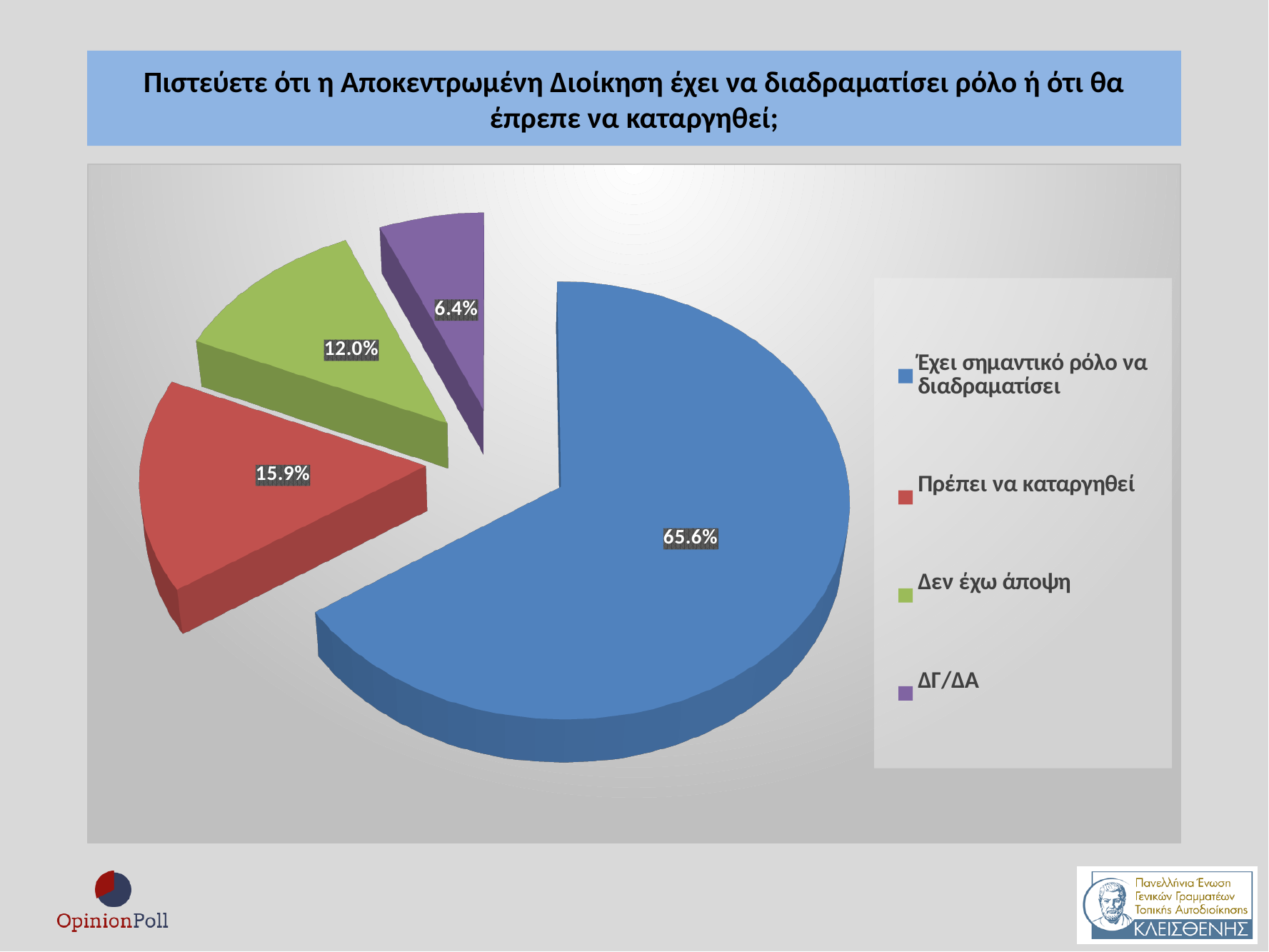
What percentage of respondents answered 'ΔΓ/ΔΑ'? 6.4% What type of chart is shown on the slide? Pie chart Which response has the largest share of the pie? Έχει σημαντικό ρόλο να διαδραματίσει Which is larger: the share for 'Πρέπει να καταργηθεί' or the share for 'Δεν έχω άποψη'? Πρέπει να καταργηθεί What percentage of respondents answered 'Έχει σημαντικό ρόλο να διαδραματίσει'? 65.6% What percentage of respondents answered 'Δεν έχω άποψη'? 12.0% What colour is the slice for 'Δεν έχω άποψη'? Green What is the difference in percentage points between 'Έχει σημαντικό ρόλο να διαδραματίσει' and 'Πρέπει να καταργηθεί'? 49.7 Which response has the smallest share of the pie? ΔΓ/ΔΑ What is the combined share of 'Δεν έχω άποψη' and 'ΔΓ/ΔΑ'? 18.4% What percentage of respondents answered 'Πρέπει να καταργηθεί'? 15.9% How many slices does the pie chart have? 4